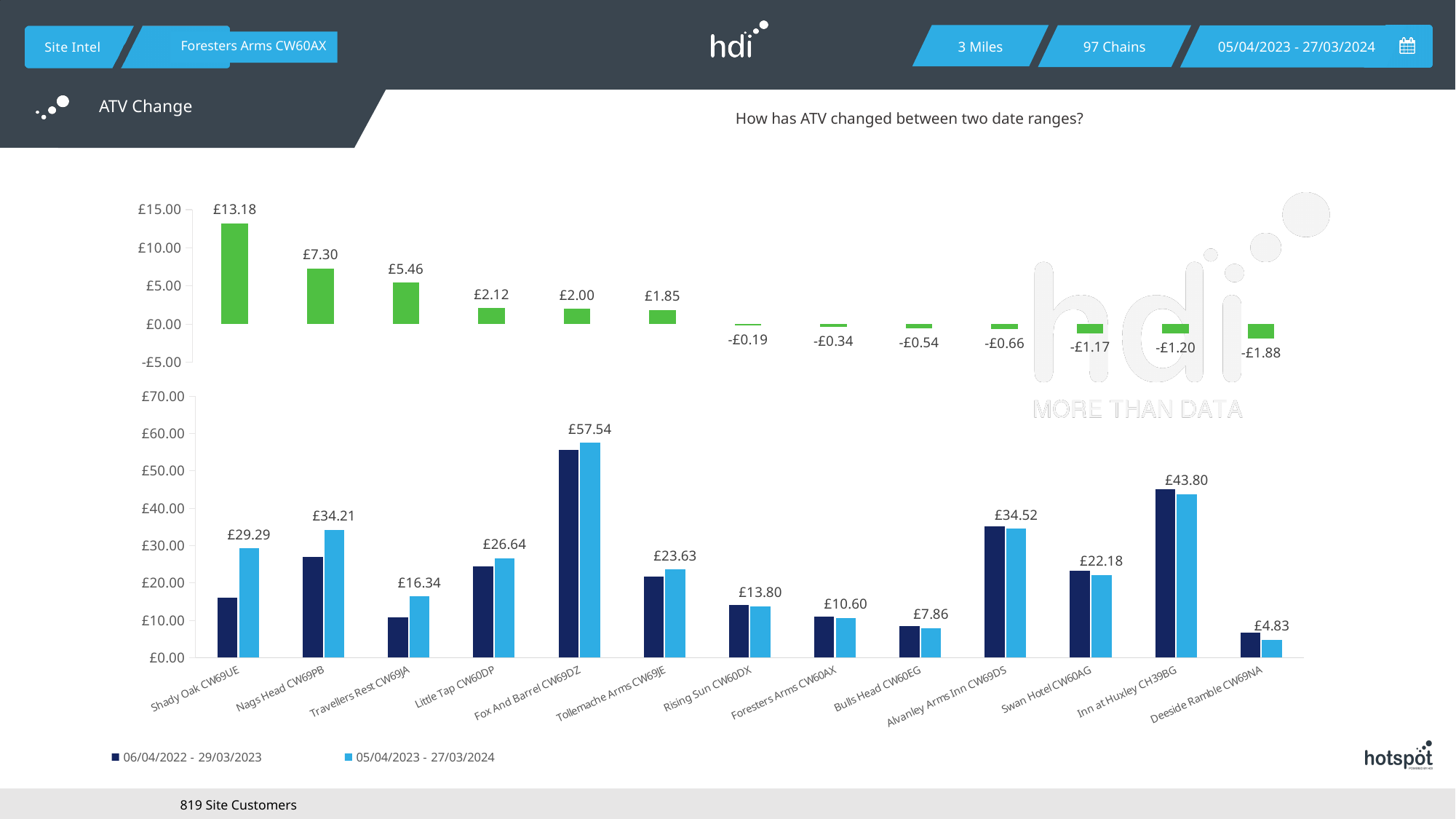
In the bottom chart, what is the value for Fox And Barrel CW69DZ in the 05/04/2023 - 27/03/2024 series? £57.54 In the bottom chart, what is the value for Deeside Ramble CW69NA in the 05/04/2023 - 27/03/2024 series? £4.83 In the bottom chart, is the 06/04/2022 - 29/03/2023 value for Shady Oak CW69UE greater or less than £20.00? less In the top chart, what is the value of the lowest bar? -£1.88 How many categories are shown on the x axis of the bottom chart? 13 How many series does the legend of the bottom chart list? 2 In the bottom chart, which category has the lowest value in the 05/04/2023 - 27/03/2024 series? Deeside Ramble CW69NA In the bottom chart, what is the difference between the 05/04/2023 - 27/03/2024 values for Nags Head CW69PB and Shady Oak CW69UE? £4.92 In the bottom chart, which is larger in the 05/04/2023 - 27/03/2024 series: Inn at Huxley CH39BG or Alvanley Arms Inn CW69DS? Inn at Huxley CH39BG What kind of chart is the bottom chart? bar chart In the bottom chart, which category has the highest value in the 05/04/2023 - 27/03/2024 series? Fox And Barrel CW69DZ In the top chart, what is the value of the highest bar? £13.18